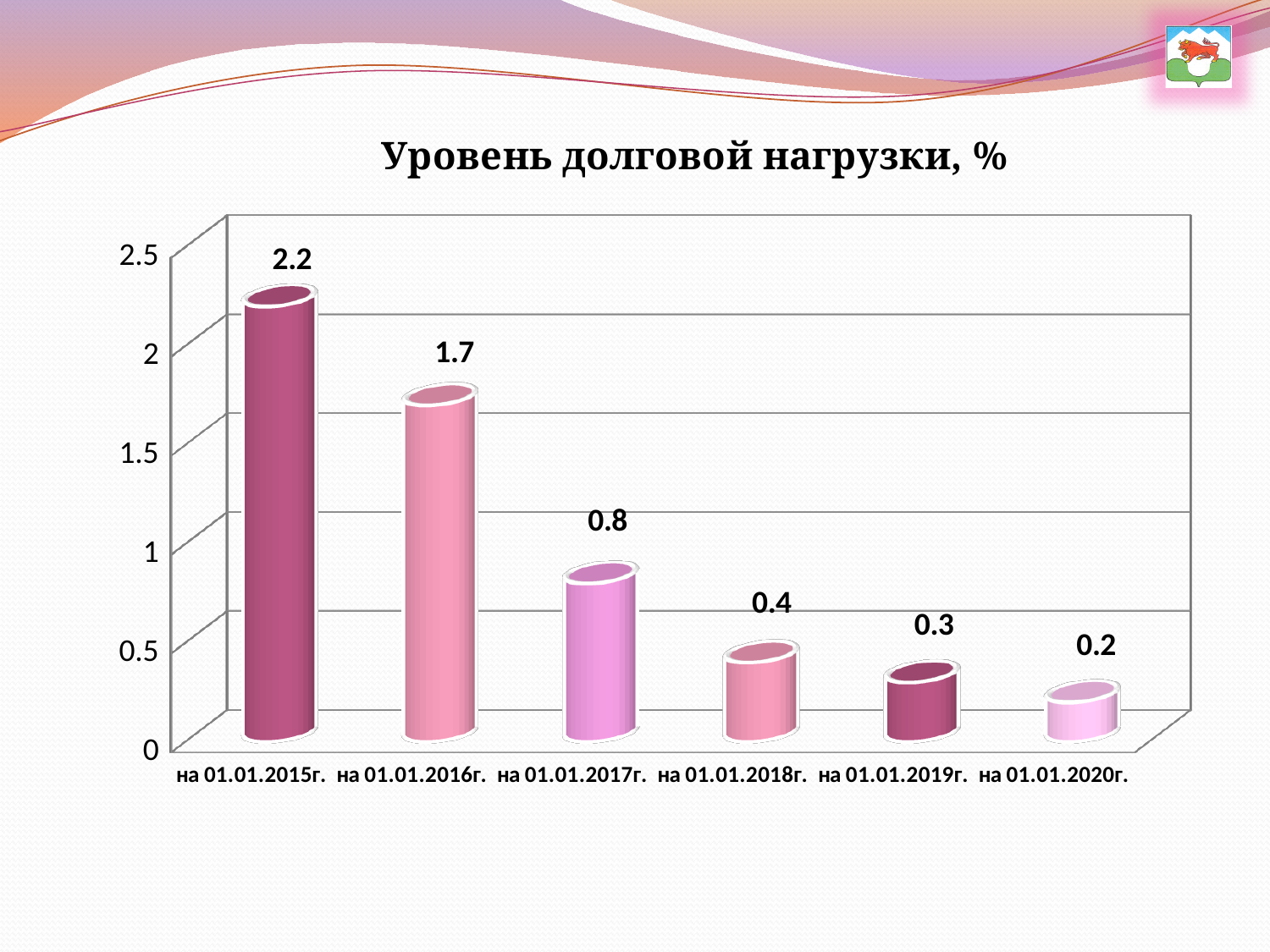
What is the title of the chart? Уровень долговой нагрузки, % Do the values rise or fall from left to right along the x axis? fall What is the value for на 01.01.2017г.? 0.8 Which is larger, the value for на 01.01.2018г. or the value for на 01.01.2019г.? на 01.01.2018г. Which category has the highest value? на 01.01.2015г. What is the difference between the values for на 01.01.2017г. and на 01.01.2018г.? 0.4 What kind of chart is shown on the slide? bar chart How many categories are shown on the x axis? 6 What is the difference between the values for на 01.01.2015г. and на 01.01.2016г.? 0.5 What is the value for на 01.01.2015г.? 2.2 What is the value for на 01.01.2020г.? 0.2 Which category has the lowest value? на 01.01.2020г.